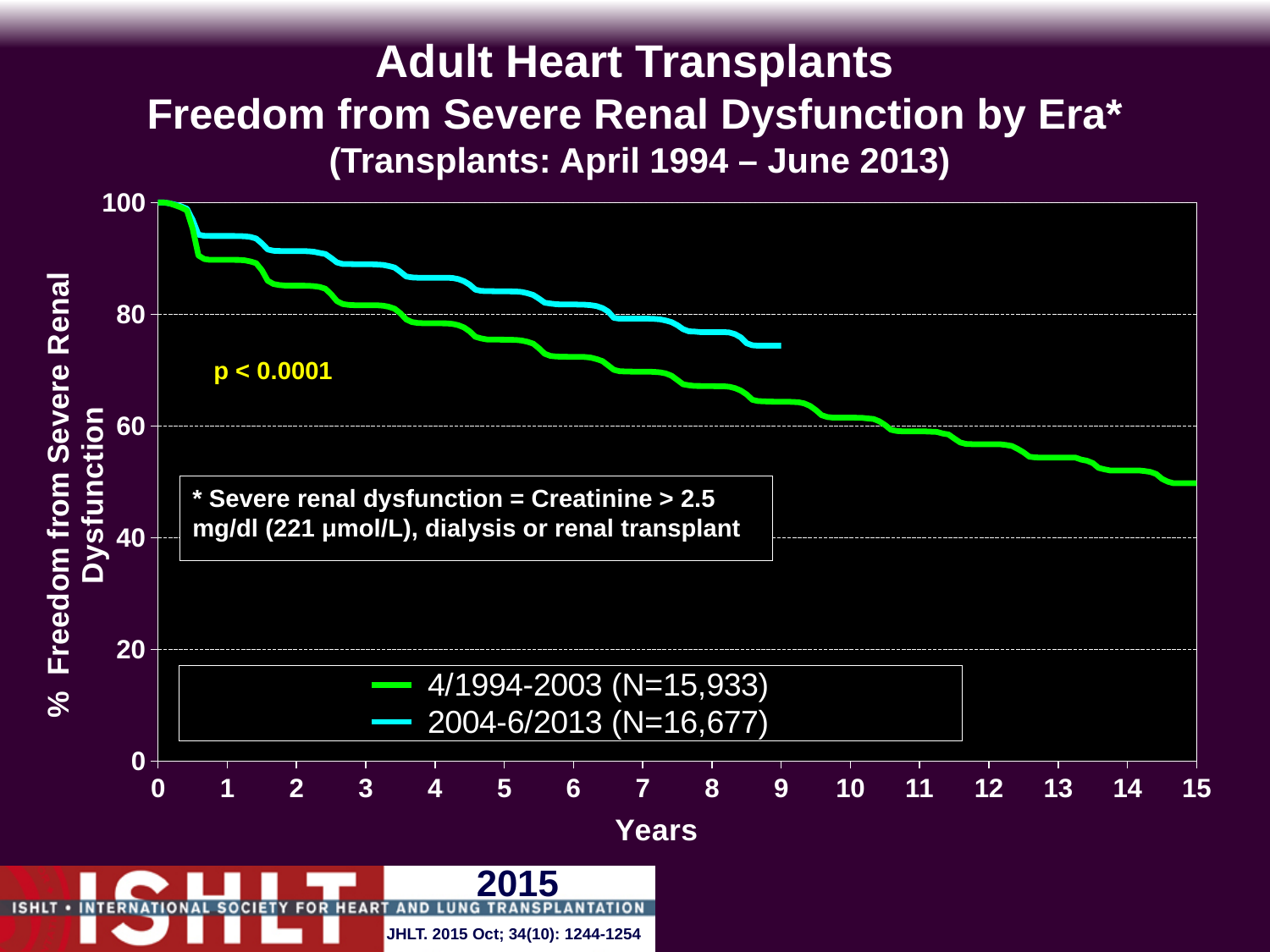
What kind of chart is shown on the slide? line chart Do the values for the 4/1994-2003 series rise or fall as years increase? fall Is the value for the 4/1994-2003 series at 15 years greater or less than 60? less Do the values for the 2004-6/2013 series rise or fall as years increase? fall Is the value for the 2004-6/2013 series at 9 years greater or less than 60? greater What p-value is shown on the chart? p < 0.0001 At 5 years, which series has the higher freedom from severe renal dysfunction, 4/1994-2003 or 2004-6/2013? 2004-6/2013 Is the value for the 2004-6/2013 series at 9 years greater or less than 80? less What N is given in the legend for the 2004-6/2013 series? N=16,677 How many series does the legend list? 2